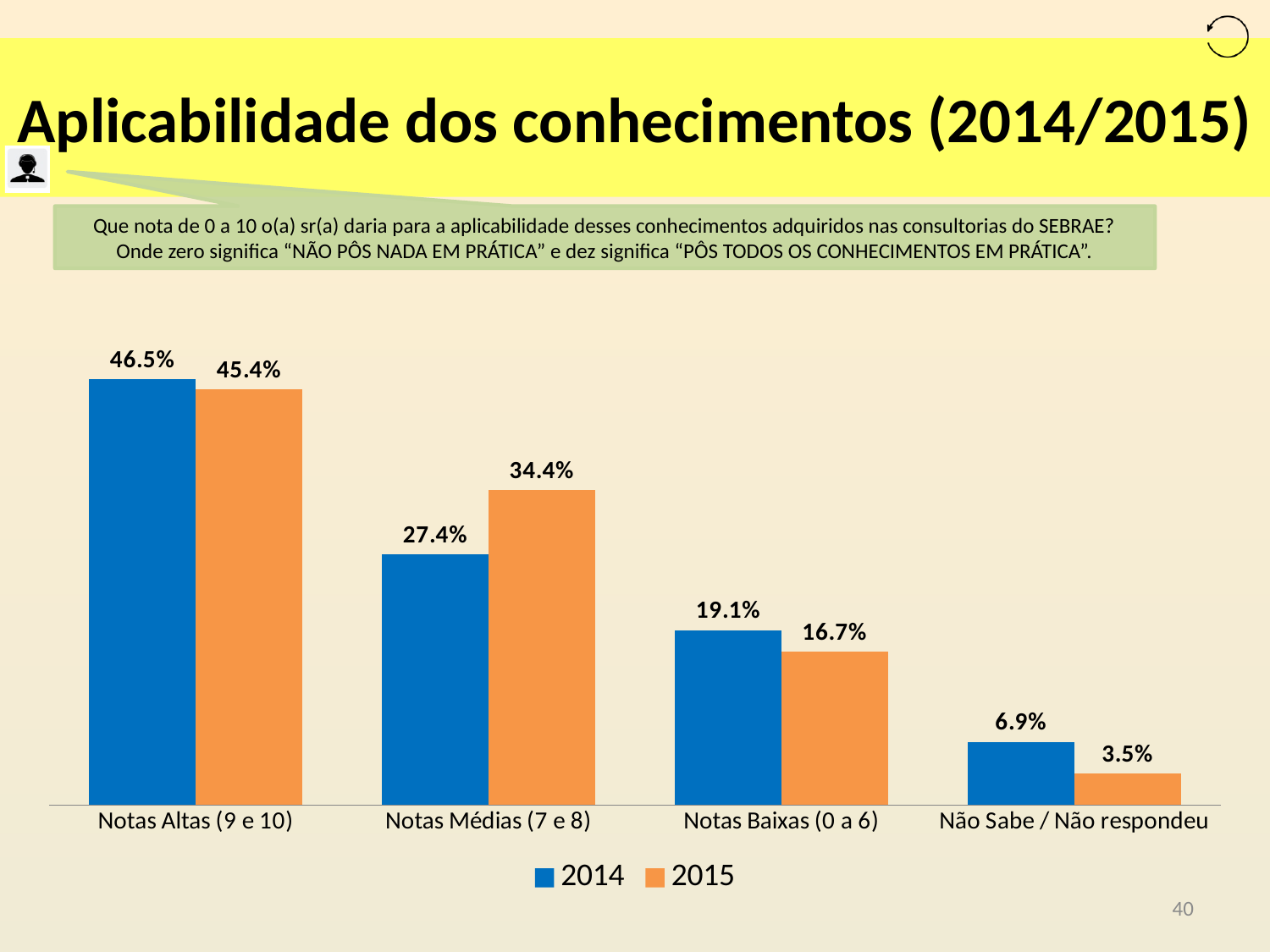
What is the difference between the 2014 and 2015 values for Notas Baixas (0 a 6)? 2.4% What is the difference between the 2015 and 2014 values for Notas Médias (7 e 8)? 7.0% What is the value for Não Sabe / Não respondeu in 2015? 3.5% Which category has the lowest value for 2014? Não Sabe / Não respondeu How many categories are shown on the x axis? 4 Which is larger for Notas Altas (9 e 10): the 2014 value or the 2015 value? 2014 How many series does the legend list? 2 Which colour represents the 2015 series in the legend? Orange What is the value for Notas Médias (7 e 8) in 2015? 34.4% What kind of chart is shown on the slide? Bar chart Which category has the highest value for 2015? Notas Altas (9 e 10) What is the value for Notas Altas (9 e 10) in 2014? 46.5%